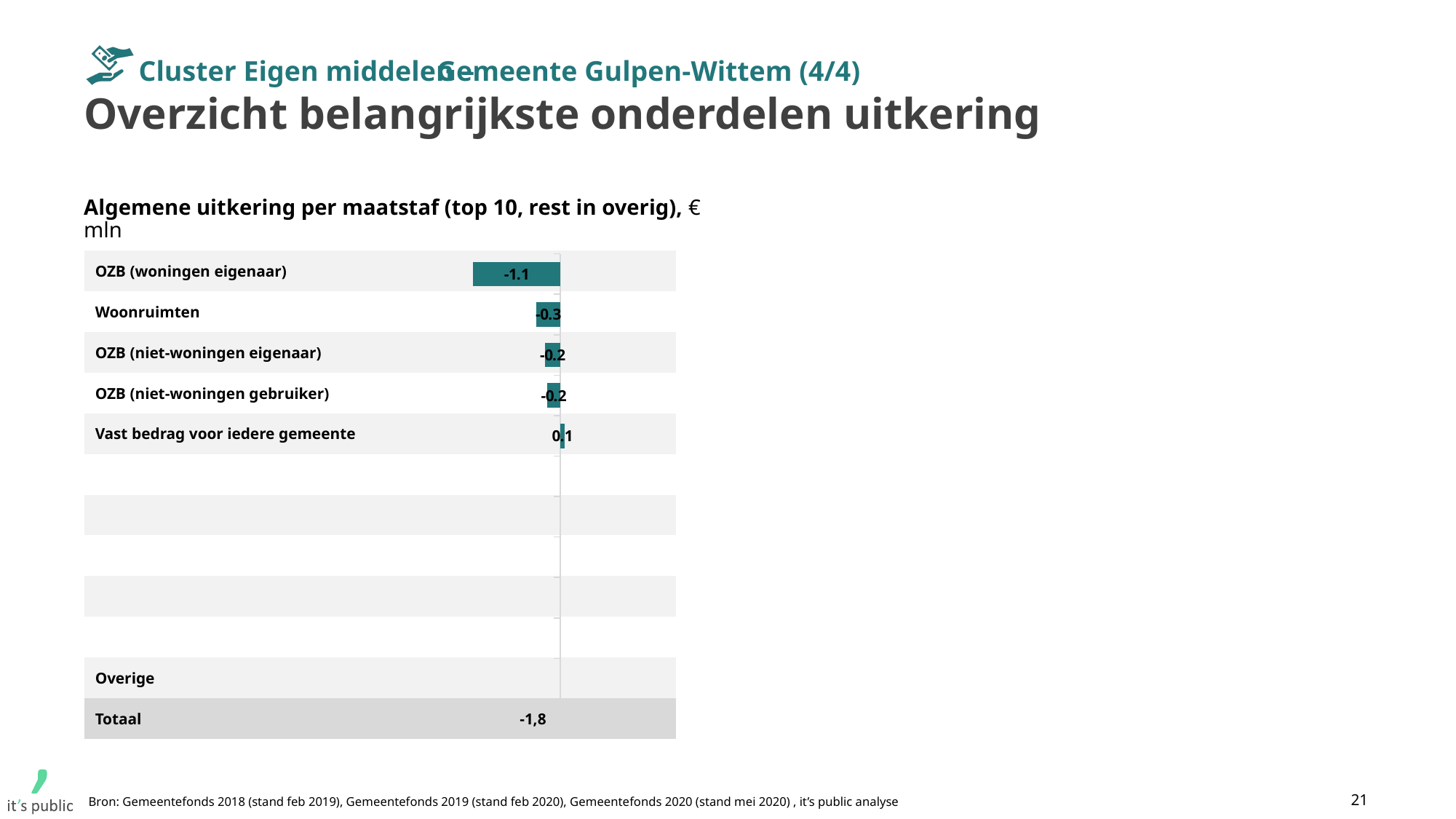
Which has the longer negative bar, Woonruimten or OZB (niet-woningen gebruiker)? Woonruimten What is the value for Woonruimten? -0.3 What is the value for Vast bedrag voor iedere gemeente? 0.1 What is the difference between the values for OZB (woningen eigenaar) and Woonruimten? 0.8 What is the value for OZB (niet-woningen eigenaar)? -0.2 How many categories have a bar with a data label plotted? 5 What is the value for OZB (woningen eigenaar)? -1.1 What is the title of the chart? Algemene uitkering per maatstaf (top 10, rest in overig), € mln What is the value shown in the Totaal row? -1,8 Which category has the lowest (most negative) value? OZB (woningen eigenaar) What kind of chart is shown on the slide? Bar chart Which category has the highest value? Vast bedrag voor iedere gemeente